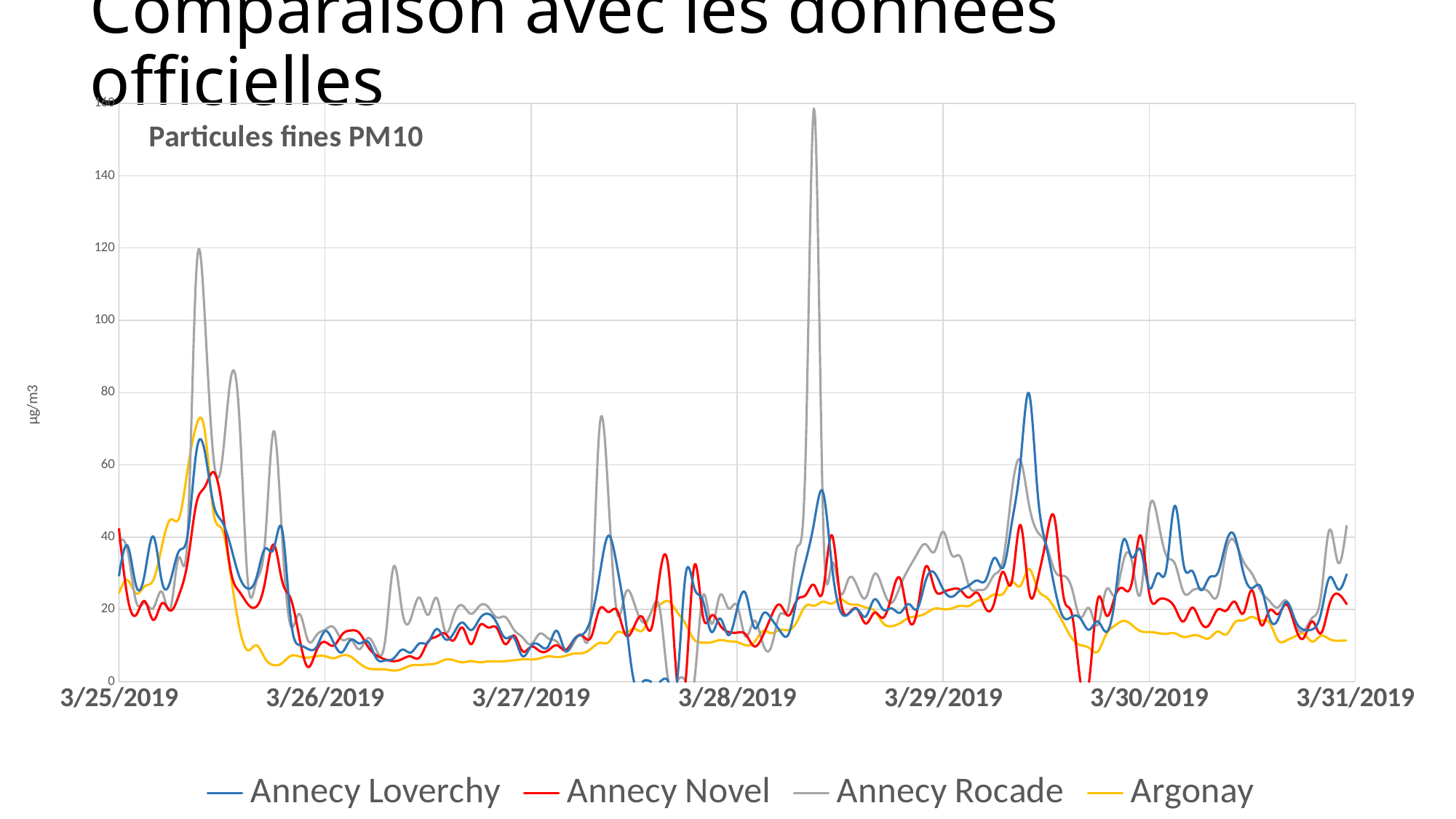
Which series has the lowest values around 3/26/2019 to 3/27/2019? Argonay Which series is drawn in yellow? Argonay Is the value of Argonay at 3/26/2019 greater or less than 20? less Which series reaches the highest peak on the chart? Annecy Rocade How many date labels are shown on the x axis? 7 What unit is shown on the y axis? µg/m3 How many series does the legend list? 4 What is the title shown inside the chart area? Particules fines PM10 Is the peak of Annecy Loverchy shortly after 3/29/2019 greater or less than 60? greater Is the peak of Annecy Rocade shortly after 3/25/2019 greater or less than 100? greater What kind of chart is shown on the slide? line chart